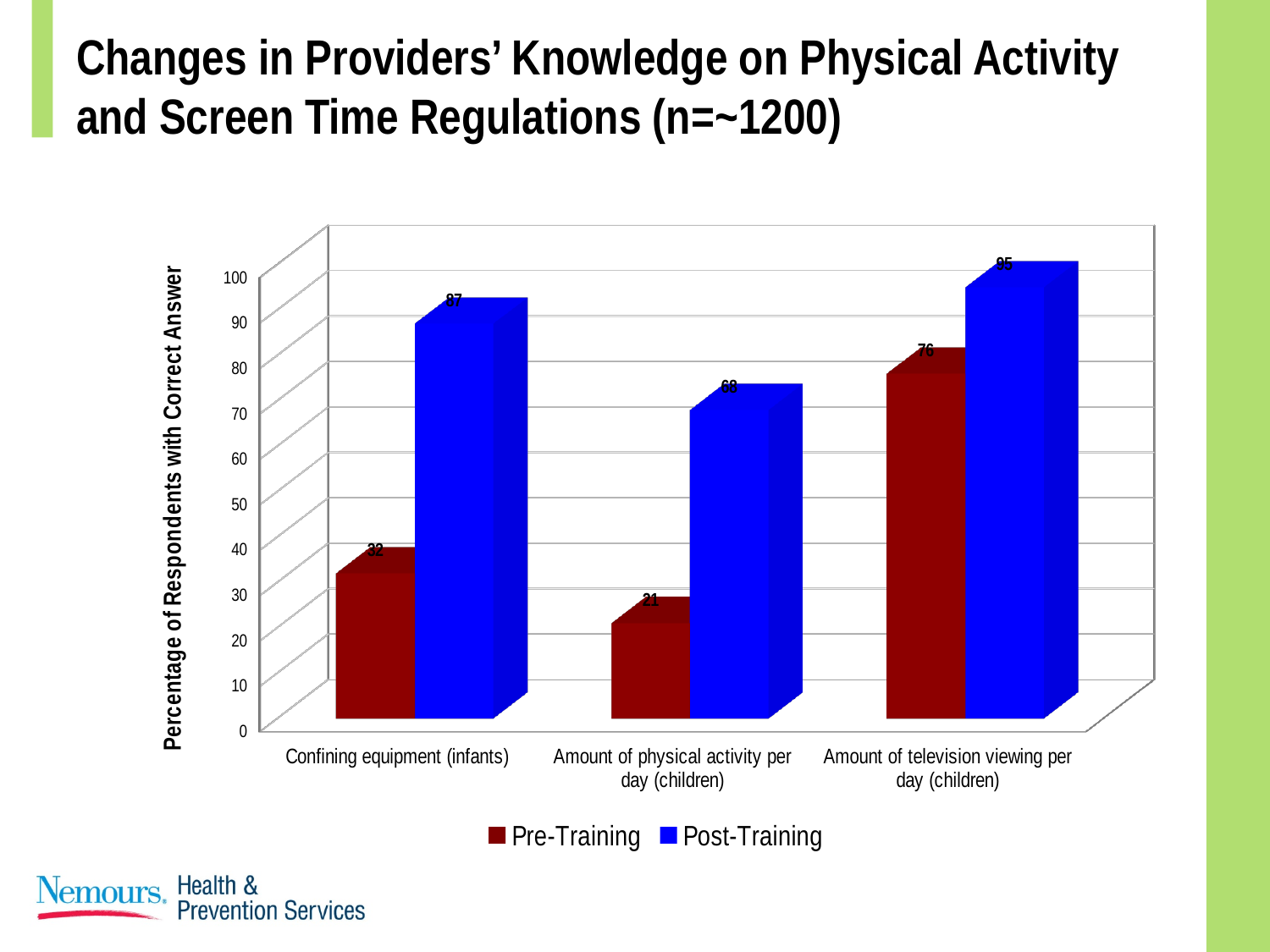
How many series does the legend list? 2 What is the Pre-Training value for Amount of physical activity per day (children)? 21 Which is larger: the Pre-Training value for Amount of television viewing per day (children) or the Post-Training value for Amount of physical activity per day (children)? Pre-Training value for Amount of television viewing per day (children) What is the difference between the Post-Training and Pre-Training values for Confining equipment (infants)? 55 Which category has the highest Post-Training value? Amount of television viewing per day (children) What is the Post-Training value for Confining equipment (infants)? 87 How many categories are shown on the x axis? 3 What kind of chart is shown on the slide? Bar chart What is the label of the vertical axis? Percentage of Respondents with Correct Answer What is the Pre-Training value for Confining equipment (infants)? 32 Which category has the lowest Pre-Training value? Amount of physical activity per day (children) What is the Post-Training value for Amount of television viewing per day (children)? 95